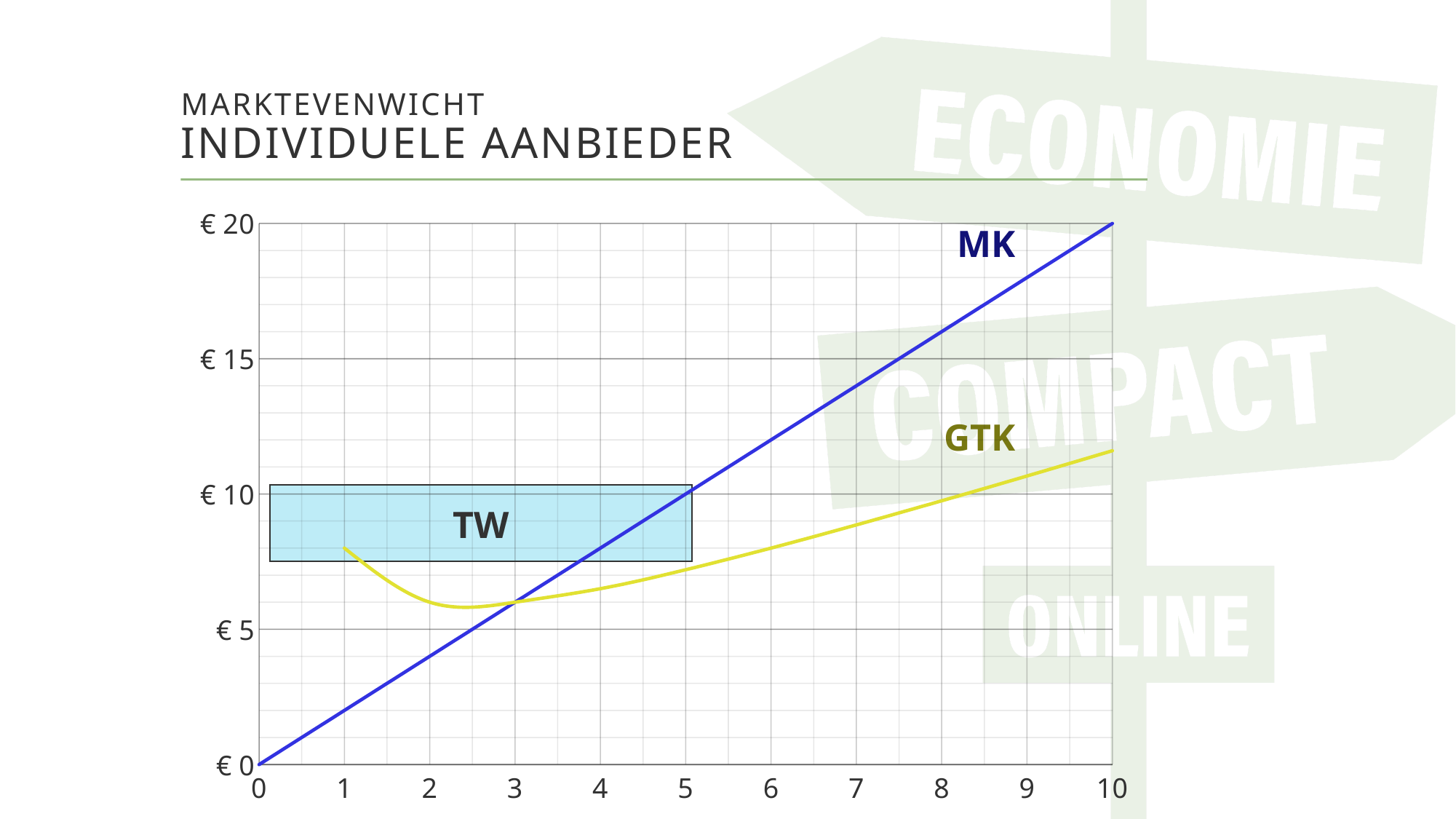
What is the value of MK at quantity 5? € 10 How many curves are labelled in the chart? 2 At quantity 1, which curve has the higher value, MK or GTK? GTK Is the value of MK at quantity 2 greater or less than € 5? less Is the value of GTK at quantity 10 greater or less than € 10? greater Is the value of GTK at quantity 1 greater or less than € 10? less At quantity 10, which curve has the higher value, MK or GTK? MK Does the MK line rise or fall as quantity increases along the x axis? rise What is the value of MK at quantity 10? € 20 What is the value of MK at quantity 0? € 0 What label is written inside the shaded blue rectangle on the chart? TW What kind of chart is shown on the slide? line chart